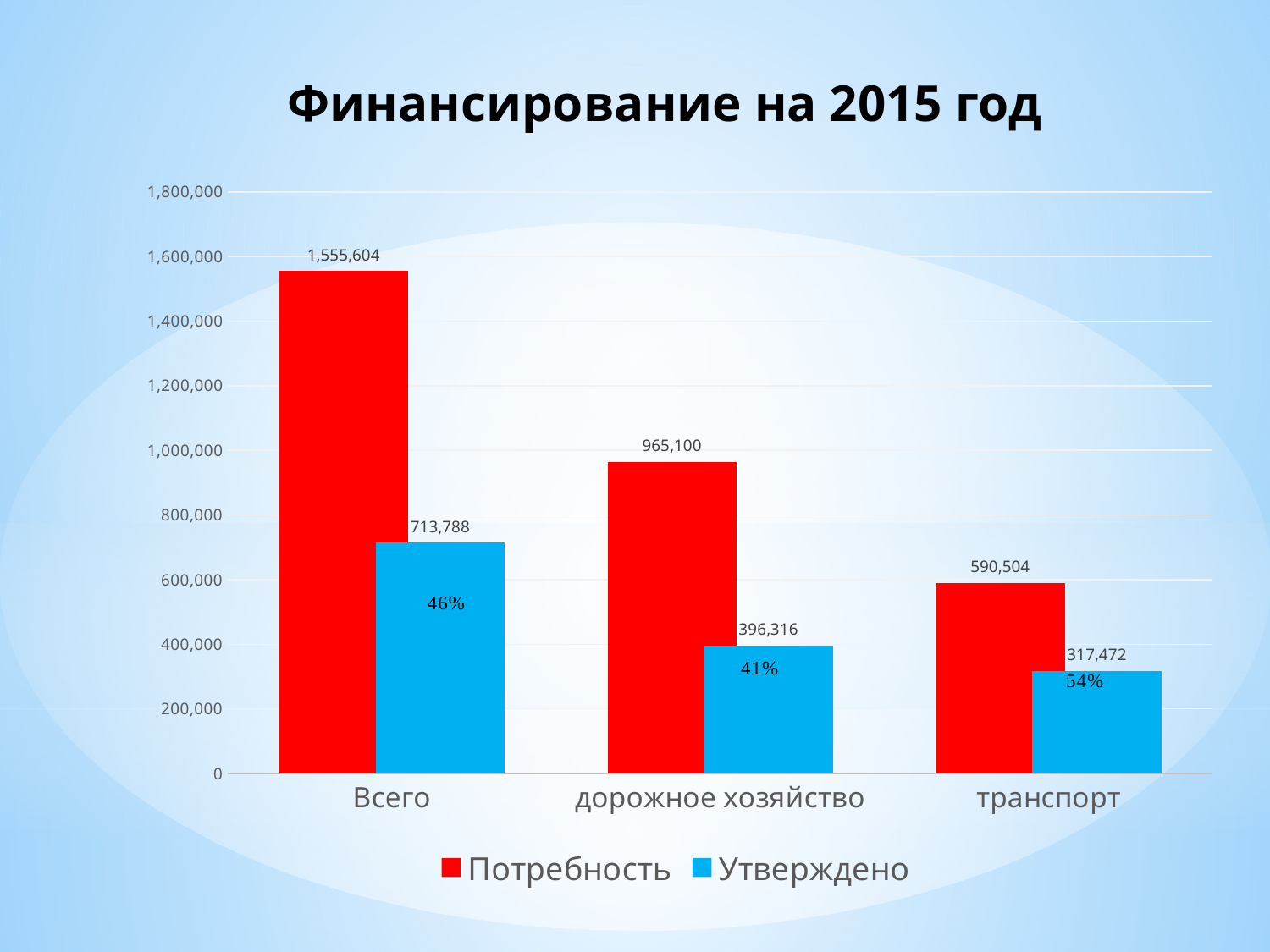
Which is larger: the Утверждено value for Всего or the Потребность value for транспорт? Утверждено value for Всего Which category has the lowest Потребность value? транспорт What is the Потребность value for Всего? 1,555,604 What percentage label is shown on the Утверждено bar for транспорт? 54% Which category has the highest Утверждено value? Всего What is the difference between Потребность and Утверждено for транспорт? 273,032 What is the Утверждено value for транспорт? 317,472 What type of chart is shown on the slide? bar chart How many categories are shown on the x axis? 3 What is the Утверждено value for дорожное хозяйство? 396,316 How many series does the legend list? 2 What is the difference between Потребность and Утверждено for дорожное хозяйство? 568,784